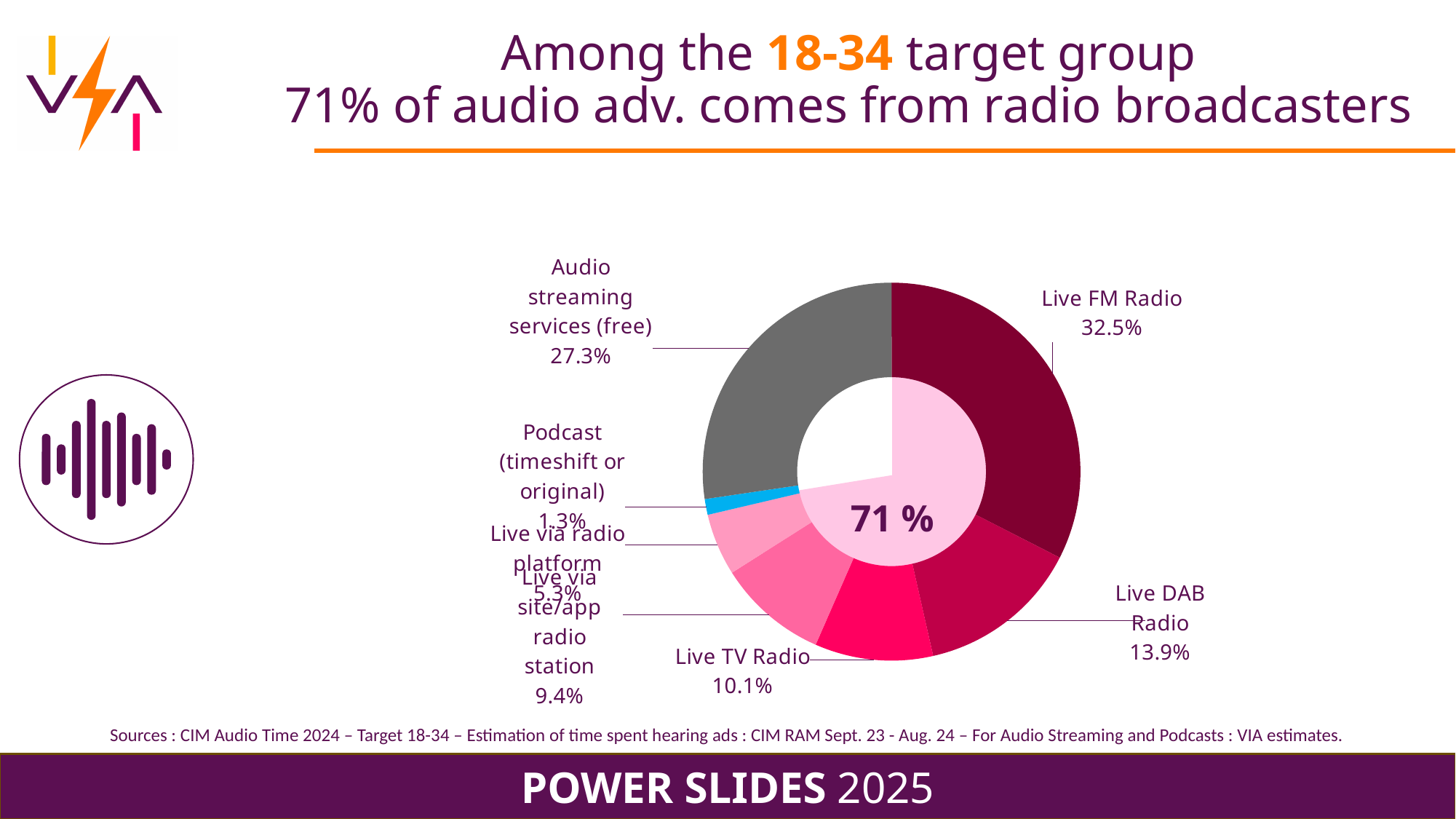
Which category has the largest share in the chart? Live FM Radio How many categories are shown in the chart? 7 What share is shown for Audio streaming services (free)? 27.3% What share of audio advertising comes from Live FM Radio? 32.5% What share is shown for Podcast (timeshift or original)? 1.3% Which category has the smallest share in the chart? Podcast (timeshift or original) What share is shown for Live TV Radio? 10.1% What share is shown for Live DAB Radio? 13.9% What kind of chart is shown on the slide? Doughnut (pie) chart Which is larger: Live DAB Radio or Live TV Radio? Live DAB Radio What is the difference in percentage points between Live FM Radio and Audio streaming services (free)? 5.2 What percentage is printed in the centre of the doughnut chart? 71 %